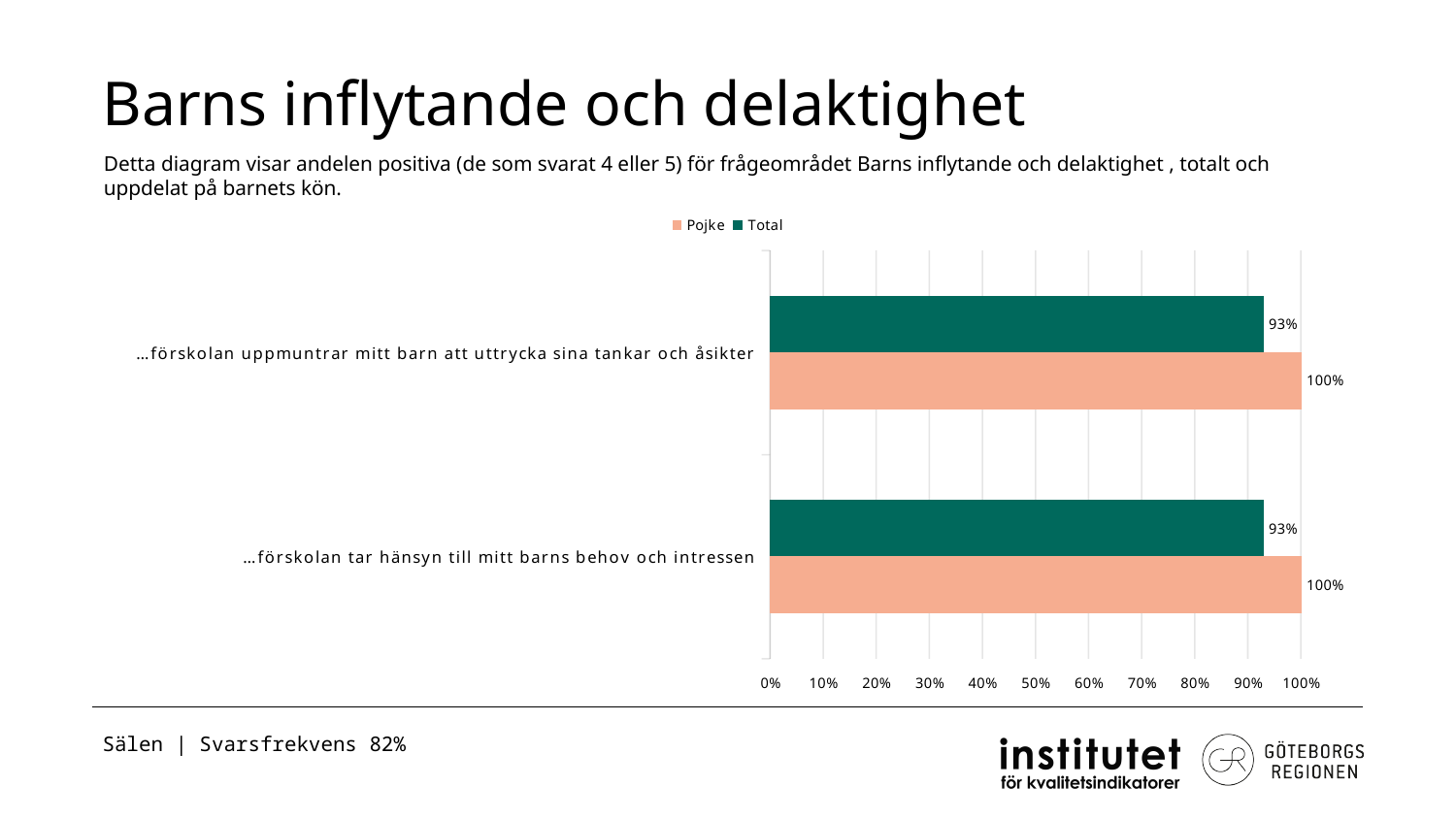
What is the Total value for "…förskolan tar hänsyn till mitt barns behov och intressen"? 93% How many categories are shown on the chart? 2 What is the Pojke value for "…förskolan uppmuntrar mitt barn att uttrycka sina tankar och åsikter"? 100% How many series does the legend list? 2 What is the Pojke value for "…förskolan tar hänsyn till mitt barns behov och intressen"? 100% Which is larger for "…förskolan uppmuntrar mitt barn att uttrycka sina tankar och åsikter": the Pojke value or the Total value? Pojke What is the title of the slide? Barns inflytande och delaktighet Which series is shown in dark green in the legend? Total What is the difference between the Pojke and Total values for "…förskolan tar hänsyn till mitt barns behov och intressen"? 7% Is the Total value for "…förskolan tar hänsyn till mitt barns behov och intressen" greater or less than 80%? greater What kind of chart is shown on the slide? Bar chart What is the Total value for "…förskolan uppmuntrar mitt barn att uttrycka sina tankar och åsikter"? 93%